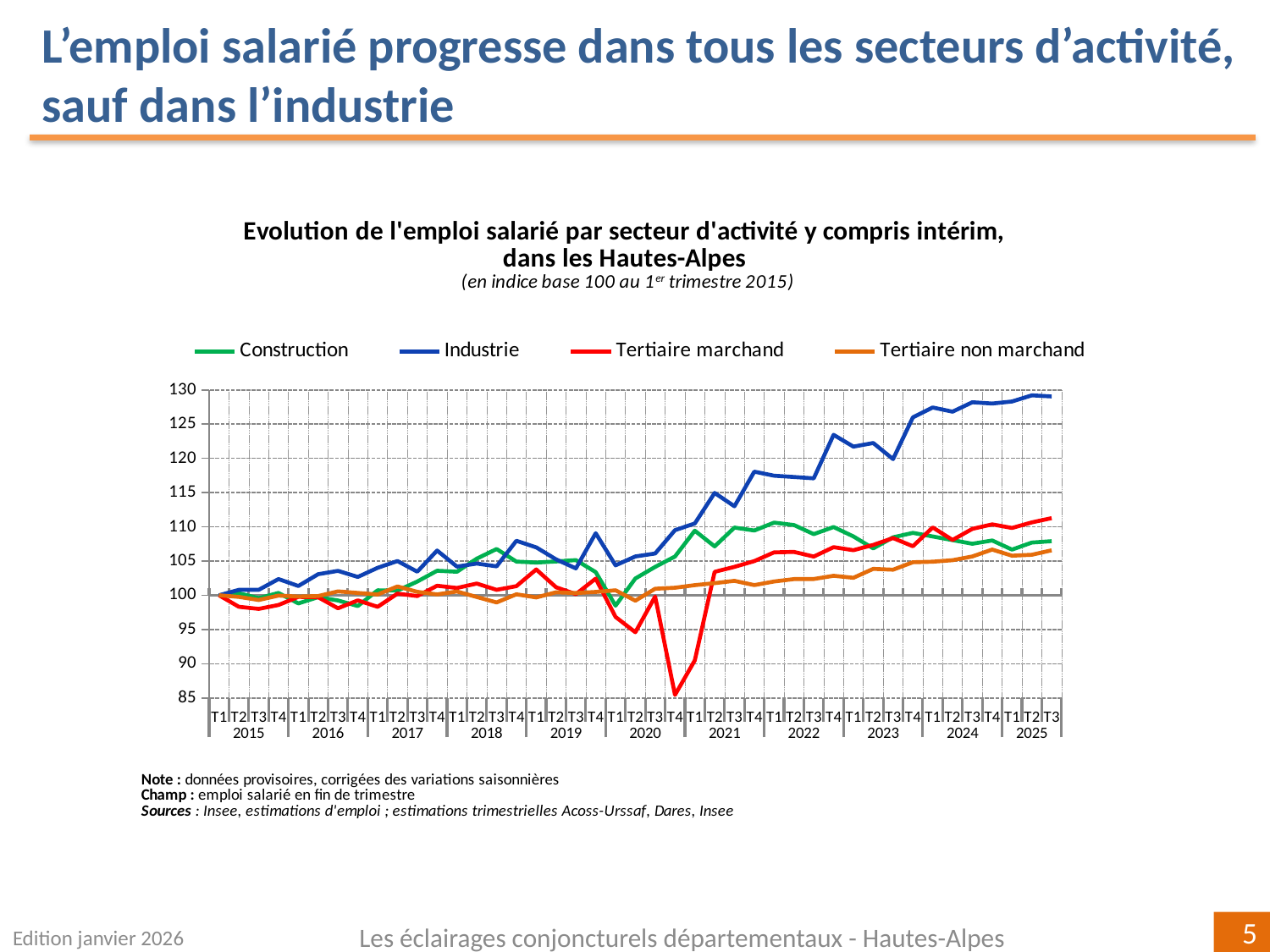
Is the value for Tertiaire non marchand at T3 2025 greater or less than 110? less What kind of chart is shown on the slide? line chart Does the Industrie series rise or fall overall from 2015 to 2025? rise How many series does the legend list? 4 At T3 2025, which is larger: Tertiaire marchand or Tertiaire non marchand? Tertiaire marchand Is the lowest value for Tertiaire marchand in 2020 greater or less than 90? less How many years are labelled on the x axis? 11 Is the value for Industrie at T3 2025 greater or less than 125? greater What colour is the Industrie line? blue Which series falls to the lowest point on the chart, in 2020? Tertiaire marchand Which series has the highest value at T3 2025? Industrie